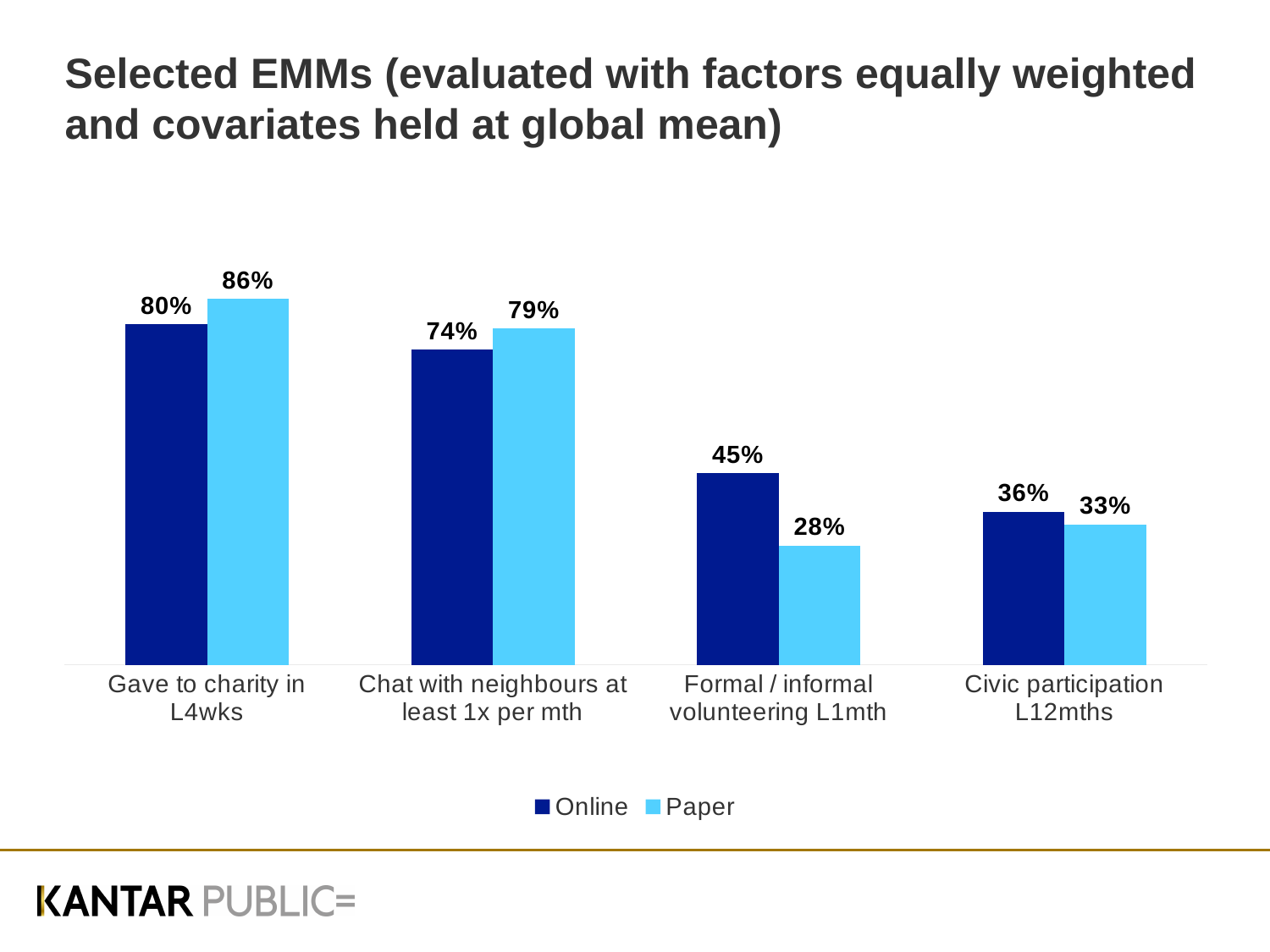
What is the difference between the Paper and Online values for 'Gave to charity in L4wks'? 6% What is the Paper value for 'Chat with neighbours at least 1x per mth'? 79% How many series does the legend list? 2 What kind of chart is shown on the slide? Bar chart What is the difference between the Online and Paper values for 'Formal / informal volunteering L1mth'? 17% Which category has the lowest Online value? Civic participation L12mths What is the Online value for 'Gave to charity in L4wks'? 80% Which series is shown in dark blue? Online For 'Civic participation L12mths', which is larger, the Online or the Paper value? Online What is the Paper value for 'Formal / informal volunteering L1mth'? 28% How many categories are shown on the x axis? 4 Which category has the highest Paper value? Gave to charity in L4wks